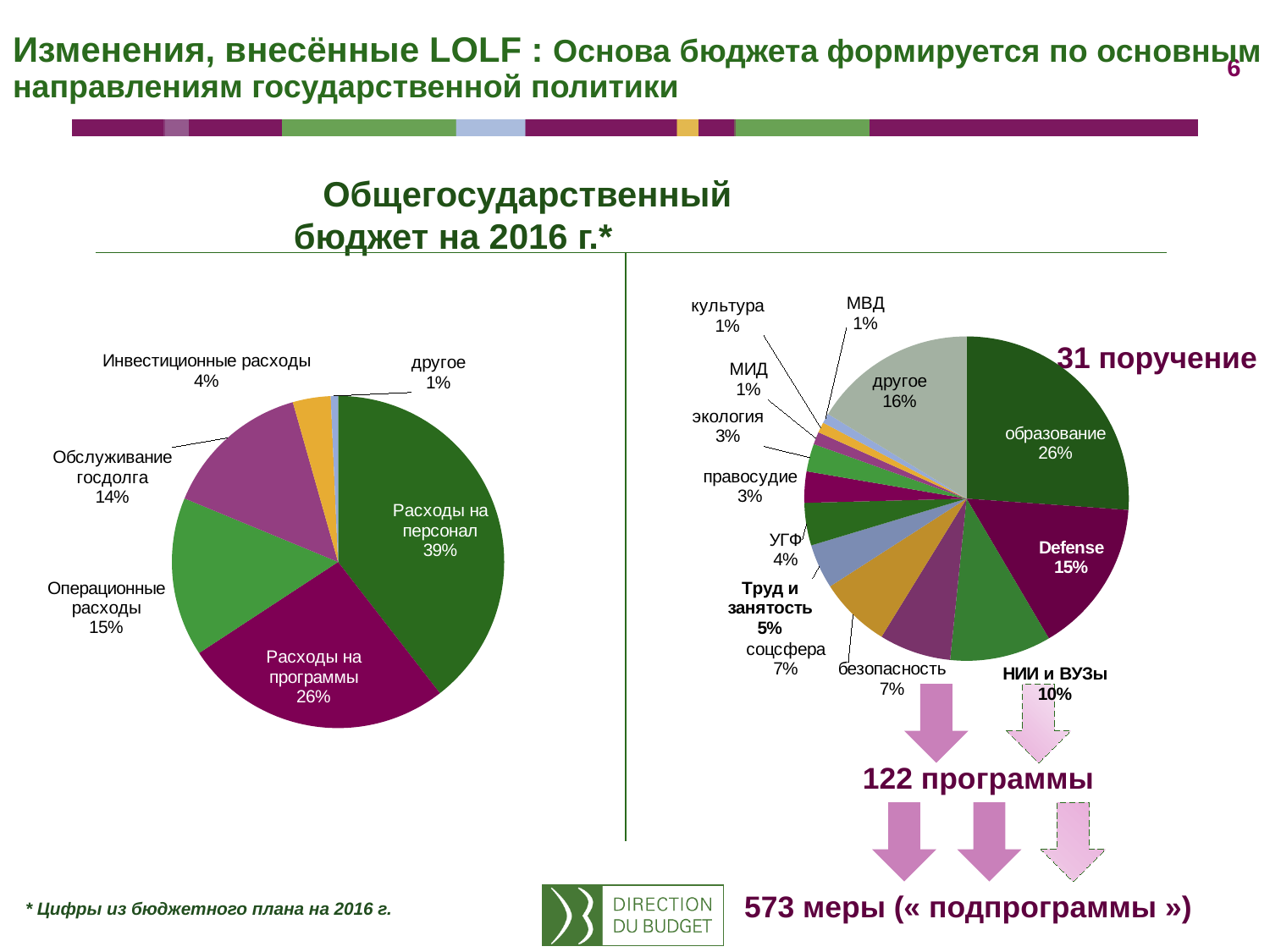
In the left pie chart, which category has the smallest share? другое In the right pie chart, what is the difference between образование and Defense? 11% In the left pie chart, which category has the largest share? Расходы на персонал In the right pie chart, how many slices are there? 13 In the right pie chart, which is larger: НИИ и ВУЗы or соцсфера? НИИ и ВУЗы In the right pie chart, which category has the largest share? образование In the left pie chart, how many slices are there? 6 In the right pie chart, what share is labelled for образование? 26% In the left pie chart, what share is labelled for Расходы на персонал? 39% In the right pie chart, what share is labelled for Defense? 15% In the left pie chart, what is the difference between Расходы на программы and Операционные расходы? 11% What type of chart is used on the left side of the slide? Pie chart